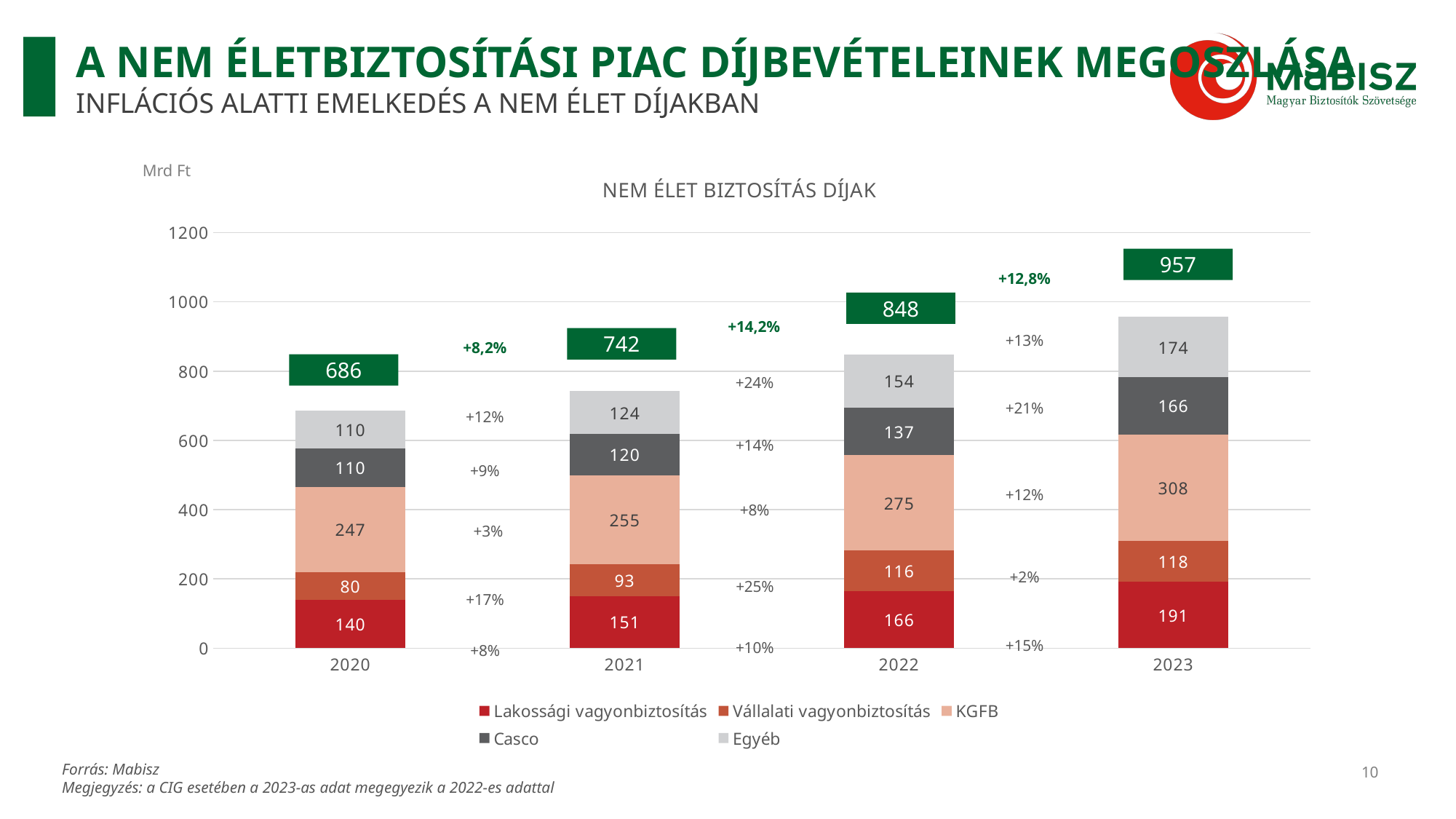
Which is larger, Vállalati vagyonbiztosítás in 2021 or in 2022? 2022 Do the total values rise or fall from 2020 to 2023? Rise What kind of chart is this? Stacked bar chart What is the total of the stacked bar for 2021? 742 What is the value of Lakossági vagyonbiztosítás in 2020? 140 What is the value of KGFB in 2022? 275 Which year has the lowest total? 2020 What is the value of Casco in 2023? 166 Which year has the highest total? 2023 How many series does the legend list? 5 What is the difference between the Egyéb values for 2023 and 2020? 64 How many years are shown on the x axis? 4